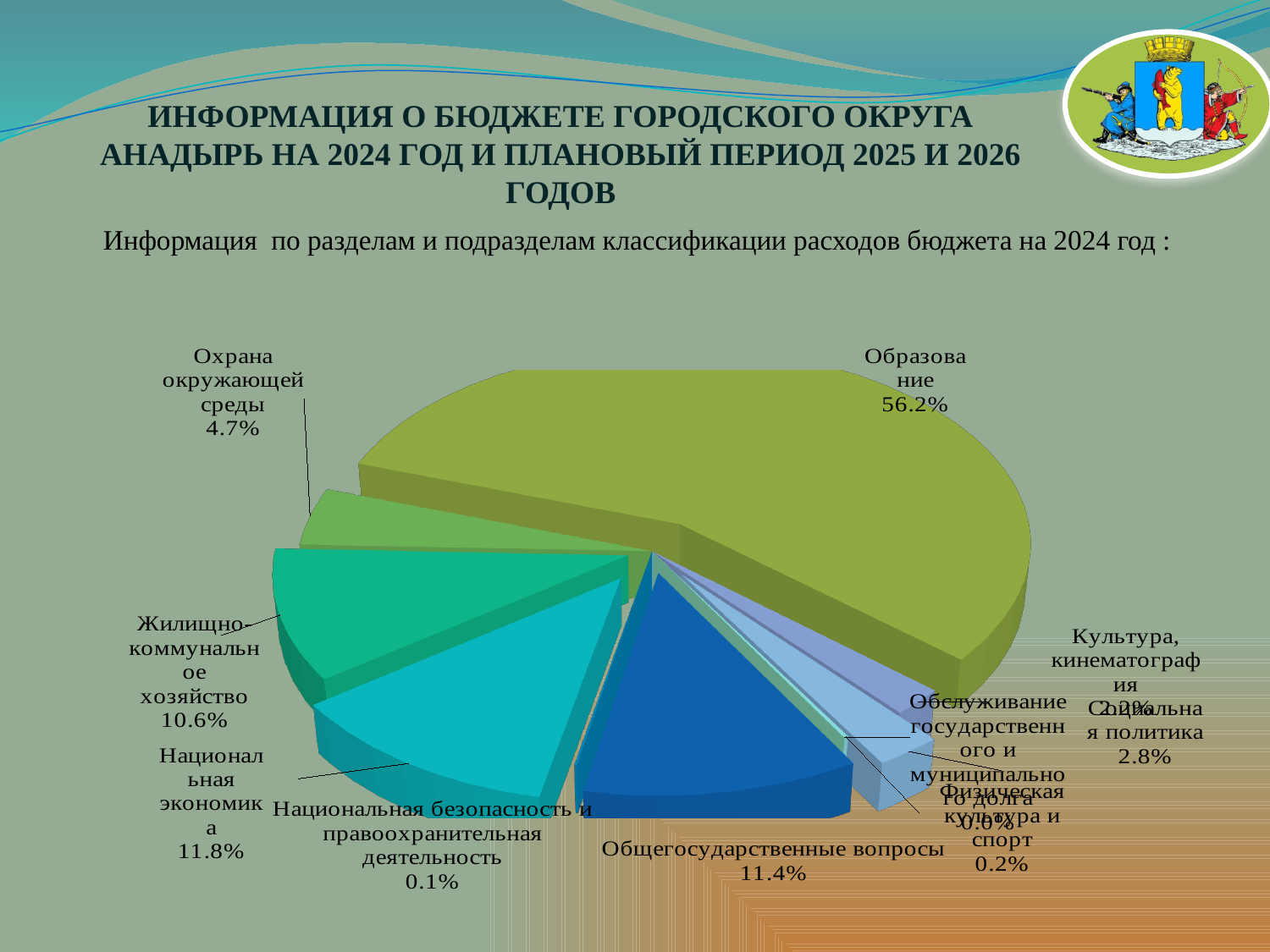
What is the value shown for Охрана окружающей среды? 4.7% What share of the 2024 budget expenditures goes to Образование? 56.2% What is the value shown for Общегосударственные вопросы? 11.4% What kind of chart is shown on the slide? pie chart What is the difference between the shares of Образование and Национальная экономика? 44.4% What is the value shown for Национальная экономика? 11.8% What is the difference between the shares of Жилищно-коммунальное хозяйство and Охрана окружающей среды? 5.9% What is the value shown for Социальная политика? 2.8% Which is larger, Национальная экономика or Общегосударственные вопросы? Национальная экономика What is the value shown for Национальная безопасность и правоохранительная деятельность? 0.1% Which section has the largest share of the pie? Образование What is the value shown for Жилищно-коммунальное хозяйство? 10.6%